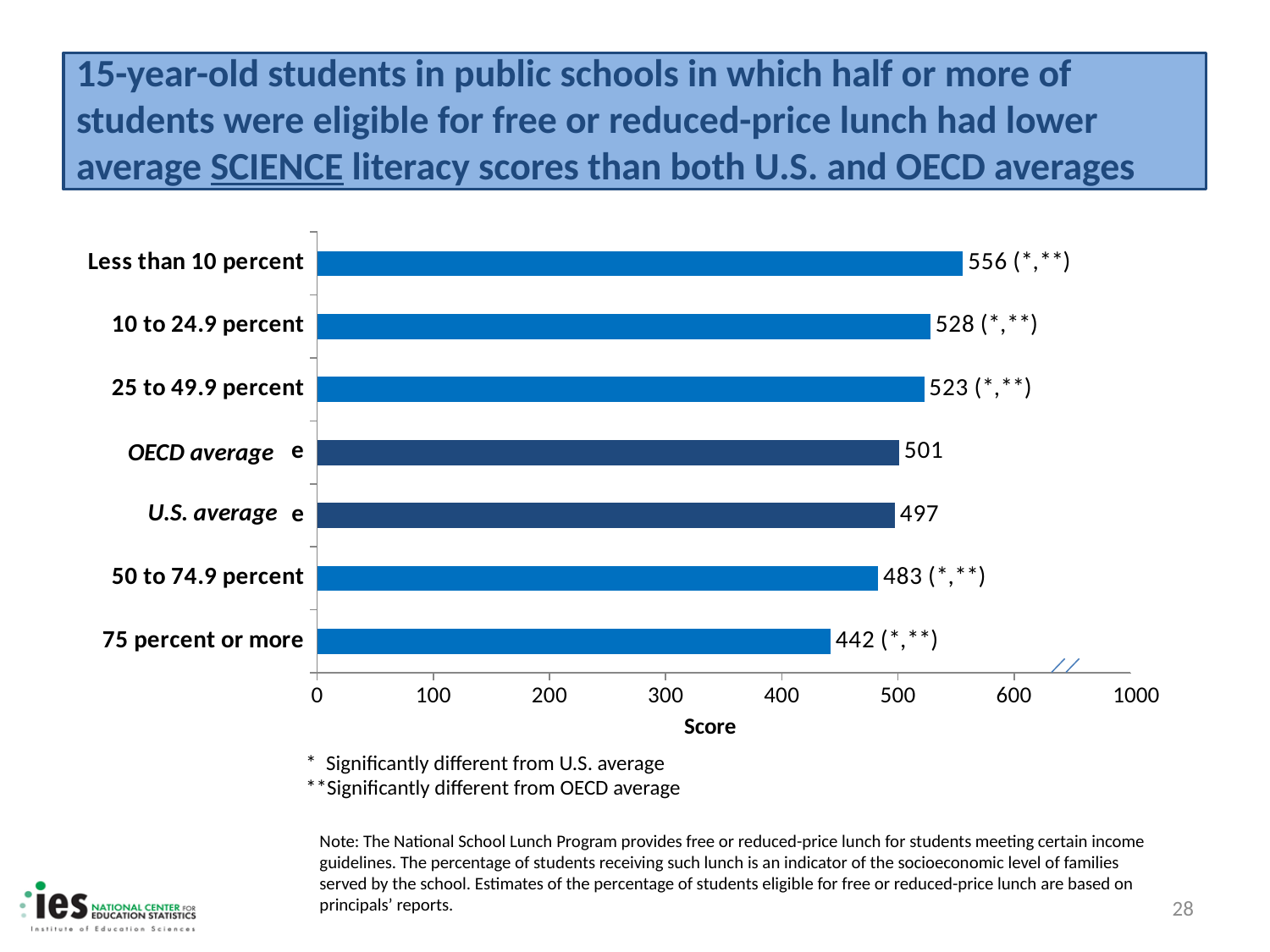
Which category has the highest average science literacy score? Less than 10 percent What is the difference between the OECD average and the U.S. average science scores? 4 What is the U.S. average science literacy score shown on the chart? 497 What is the label of the horizontal axis? Score What is the average science literacy score for schools with less than 10 percent of students eligible for free or reduced-price lunch? 556 What is the difference between the score for schools with less than 10 percent eligible and schools with 75 percent or more eligible? 114 What is the OECD average science literacy score shown on the chart? 501 What is the average science literacy score for schools with 75 percent or more of students eligible for free or reduced-price lunch? 442 How many bars are shown on the chart? 7 Which is larger, the score for 50 to 74.9 percent or the U.S. average? U.S. average Which category has the lowest average science literacy score? 75 percent or more What kind of chart is shown on the slide? Bar chart